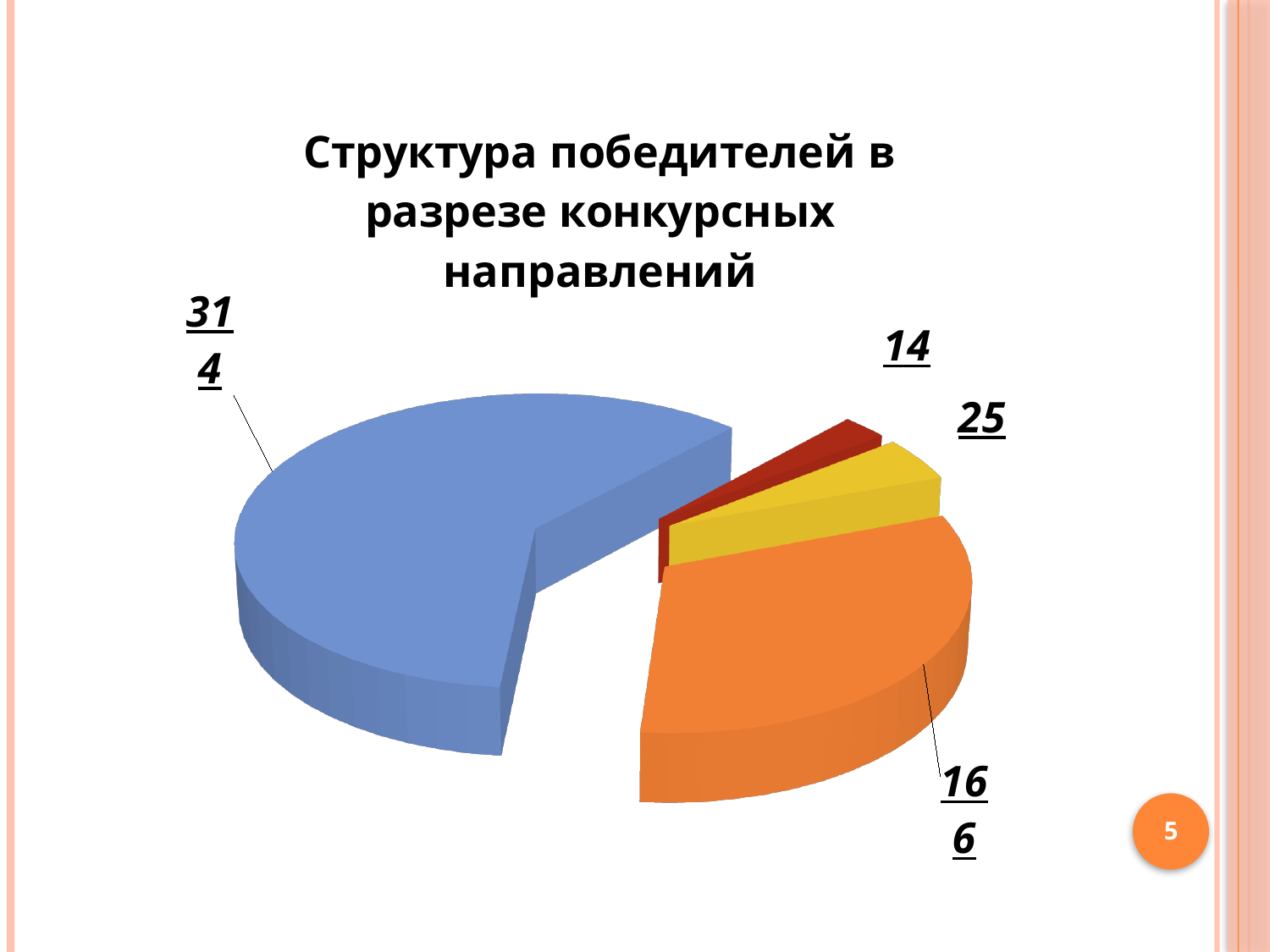
What is the total of all the slice values in the pie chart? 519 What is the value of the yellow slice? 25 What kind of chart is shown on the slide? pie chart What is the value of the dark red slice? 14 What is the value of the blue slice? 314 What is the title of the chart? Структура победителей в разрезе конкурсных направлений Which slice has the smallest value? the dark red slice (14) Which is larger, the yellow slice or the dark red slice? the yellow slice How many slices does the pie chart have? 4 What is the value of the orange slice? 166 What is the difference between the blue slice and the orange slice? 148 Which slice has the largest value? the blue slice (314)